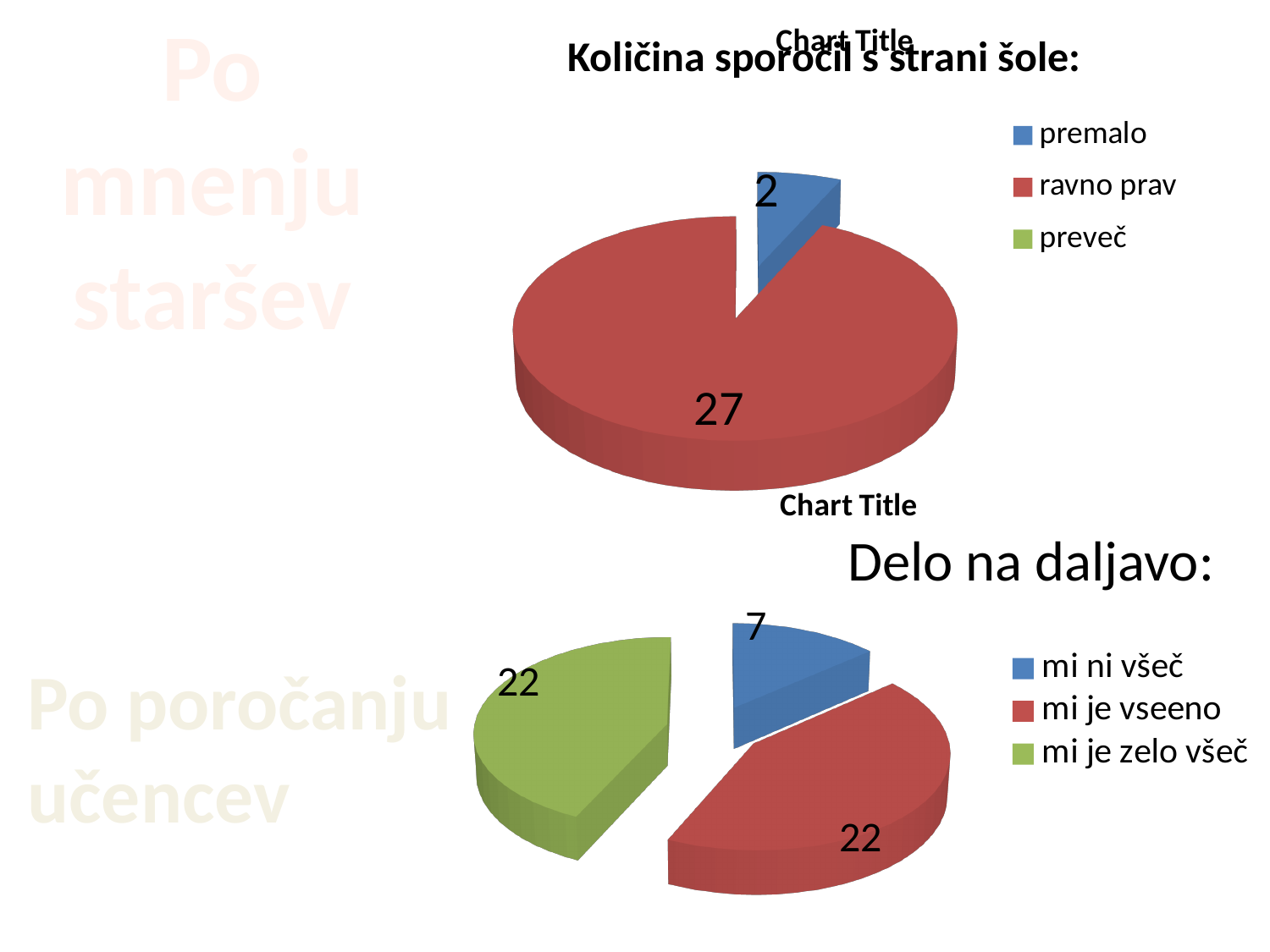
In the bottom chart 'Delo na daljavo:', what is the difference between the values for 'mi je zelo všeč' and 'mi ni všeč'? 15 In the bottom chart 'Delo na daljavo:', what is the total of all the slices? 51 In the bottom chart 'Delo na daljavo:', which category has the smallest slice? mi ni všeč How many entries does the legend of the top chart 'Količina sporočil s strani šole:' list? 3 In the top chart 'Količina sporočil s strani šole:', what is the value for 'ravno prav'? 27 In the top chart 'Količina sporočil s strani šole:', what is the value for 'premalo'? 2 In the bottom chart 'Delo na daljavo:', what is the value for 'mi ni všeč'? 7 What kind of chart is the top chart 'Količina sporočil s strani šole:'? pie chart In the bottom chart 'Delo na daljavo:', which is larger, the value for 'mi je vseeno' or the value for 'mi ni všeč'? mi je vseeno In the top chart 'Količina sporočil s strani šole:', what is the difference between the values for 'ravno prav' and 'premalo'? 25 In the bottom chart 'Delo na daljavo:', what is the value for 'mi je vseeno'? 22 In the top chart 'Količina sporočil s strani šole:', which category has the largest slice? ravno prav